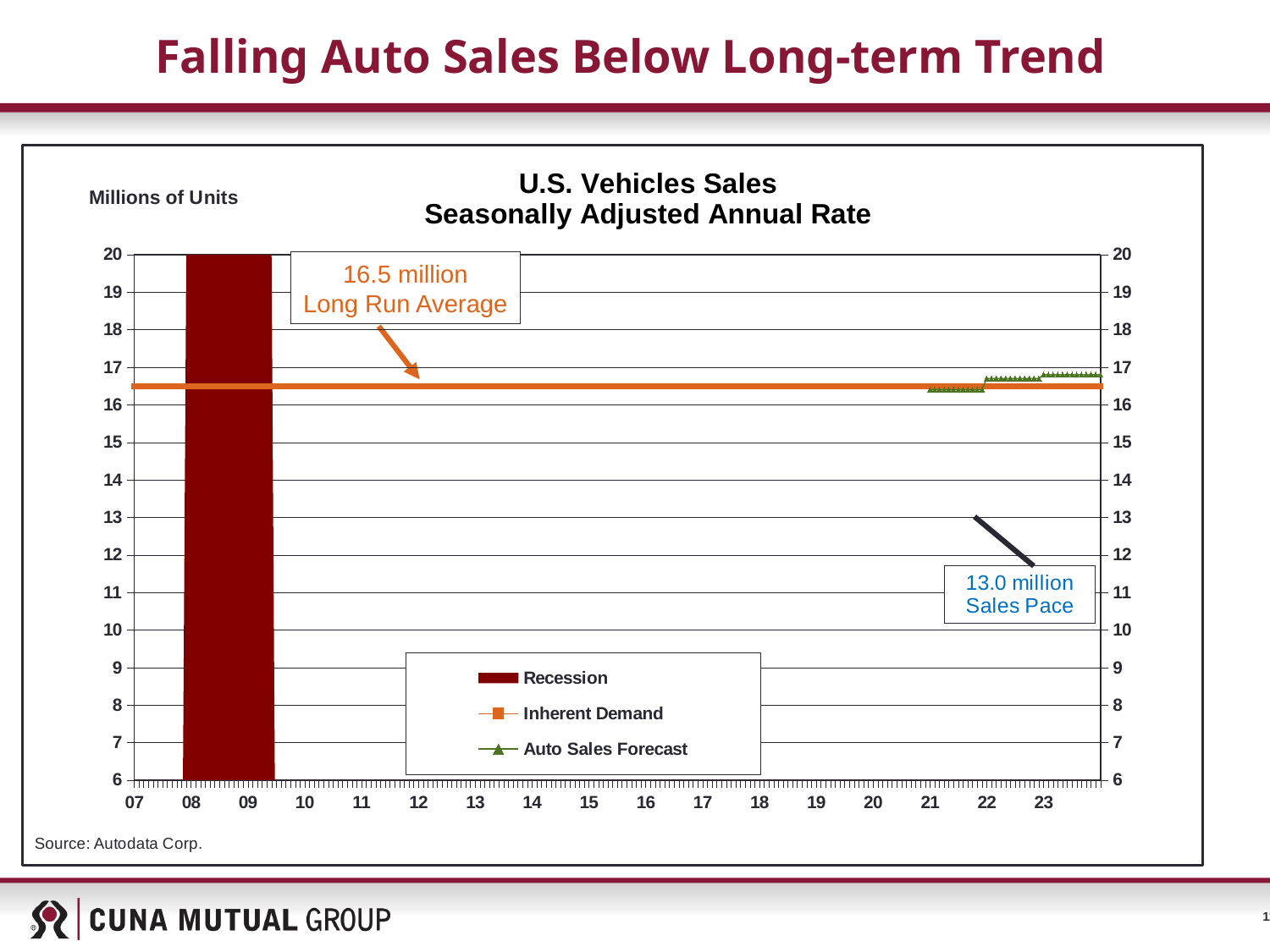
Is the Inherent Demand line greater or less than 17? less What is the highest value shown on the vertical axis? 20 What source is cited below the chart? Autodata Corp. Is the Inherent Demand line greater or less than 16? greater Does the Auto Sales Forecast line rise or fall from 21 to 23? rise What is the lowest value shown on the vertical axis? 6 Is the Auto Sales Forecast value in 23 greater or less than 17? less How many series does the legend list? 3 What value does the annotation give for the Sales Pace? 13.0 million What value does the annotation give for the Long Run Average? 16.5 million What are the three series named in the legend? Recession, Inherent Demand, Auto Sales Forecast